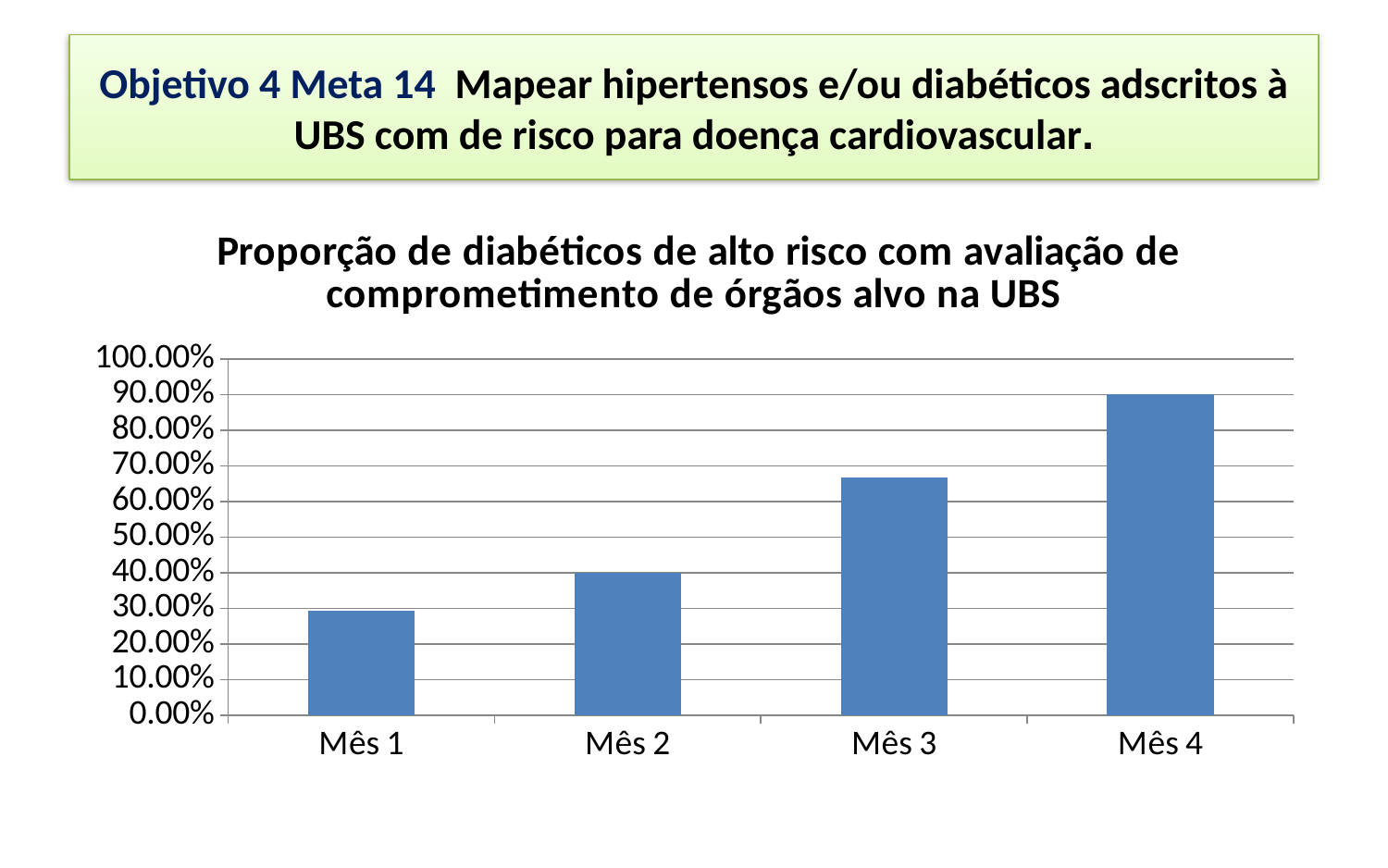
How many months (categories) are shown on the x axis of the chart? 4 Which month has the highest proportion in the chart? Mês 4 Which month has the lowest proportion in the chart? Mês 1 Do the values rise or fall from Mês 1 to Mês 4? Rise Is the value for Mês 1 greater or less than 20.00%? greater Is the value for Mês 3 greater or less than 60.00%? greater Which is larger, the value for Mês 2 or the value for Mês 3? Mês 3 What is the highest value shown on the y axis of the chart? 100.00% What kind of chart is shown on the slide? Bar chart What is the title of the chart? Proporção de diabéticos de alto risco com avaliação de comprometimento de órgãos alvo na UBS Is the value for Mês 3 greater or less than 70.00%? less